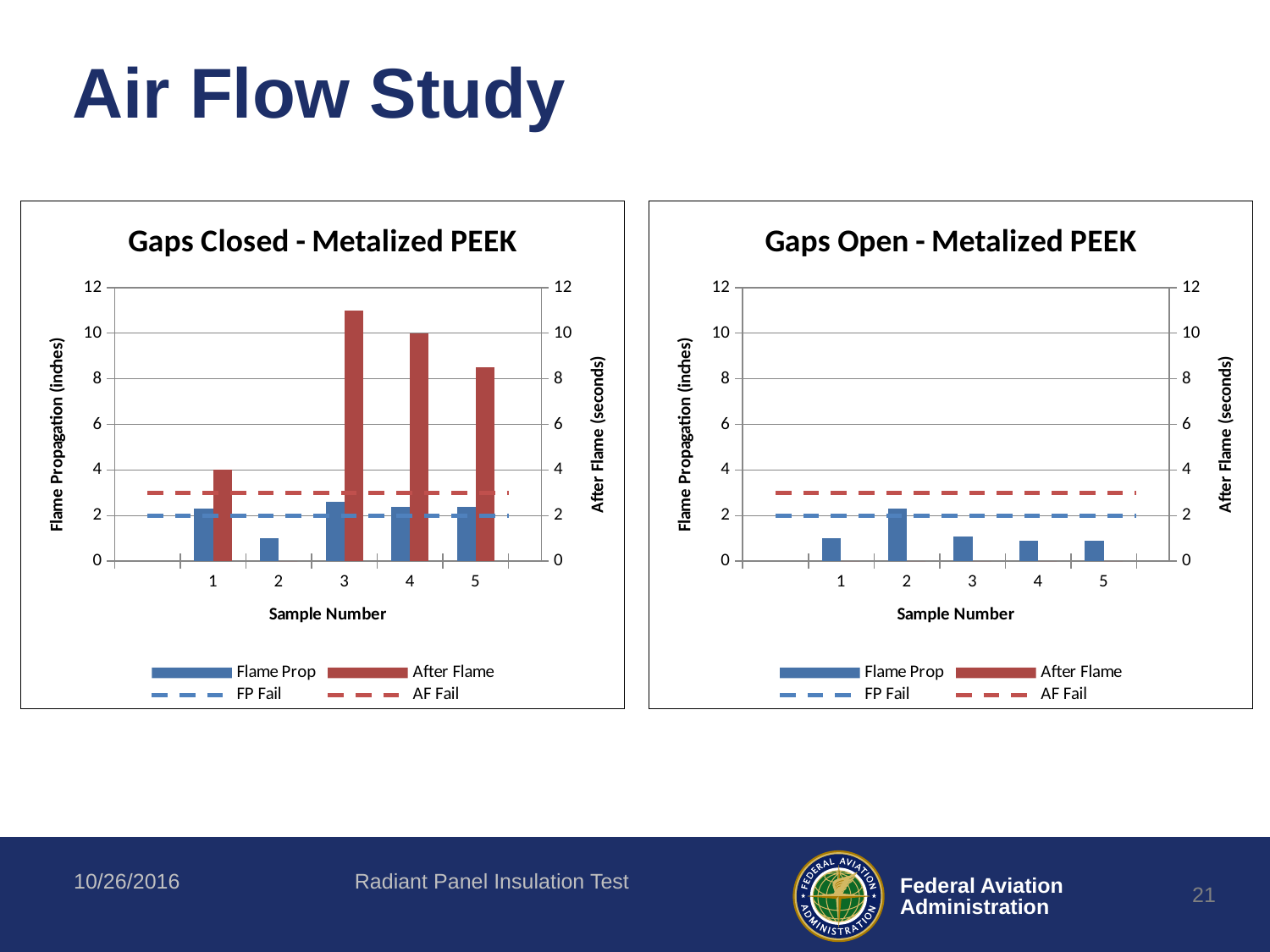
In the "Gaps Closed - Metalized PEEK" chart, how many sample numbers are shown on the x axis? 5 In the "Gaps Closed - Metalized PEEK" chart, which sample number has the highest After Flame value? 3 In the "Gaps Closed - Metalized PEEK" chart, which is larger: the After Flame value for sample 1 or for sample 4? Sample 4 In the "Gaps Closed - Metalized PEEK" chart, is the After Flame value for sample 5 greater or less than 8? greater What is the label of the left vertical axis in the "Gaps Open - Metalized PEEK" chart? Flame Propagation (inches) How many entries does the legend of the "Gaps Open - Metalized PEEK" chart list? 4 In the "Gaps Open - Metalized PEEK" chart, which sample number has the highest Flame Prop value? 2 In the "Gaps Closed - Metalized PEEK" chart, which sample number has the lowest Flame Prop value? 2 What kind of chart is the "Gaps Closed - Metalized PEEK" chart? Bar chart In the "Gaps Open - Metalized PEEK" chart, is the Flame Prop value for sample 1 greater or less than 2? less In the "Gaps Closed - Metalized PEEK" chart, is the Flame Prop value for sample 2 greater or less than 2? less